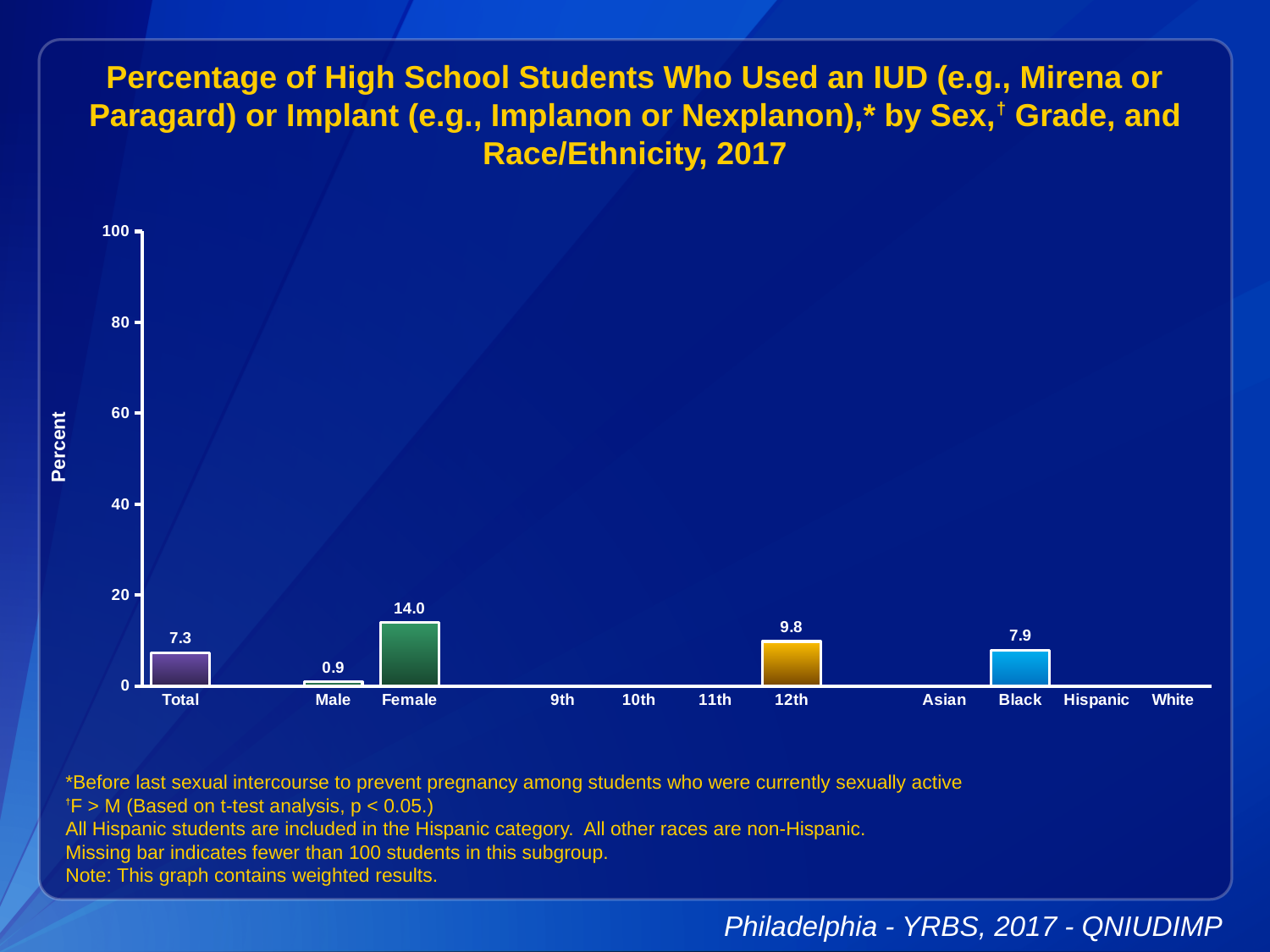
Which category with a plotted bar has the lowest value? Male What is the value for 12th grade? 9.8 Which category has the highest value? Female How many categories are labeled on the x axis? 11 What is the difference between the Female and Male values? 13.1 What is the value for Black students? 7.9 Is the value for Female greater or less than 20? less What kind of chart is shown? bar chart What is the value for Female? 14.0 Which is larger, the value for 12th grade or the value for Black students? 12th grade What is the value for Male? 0.9 What is the value for Total? 7.3